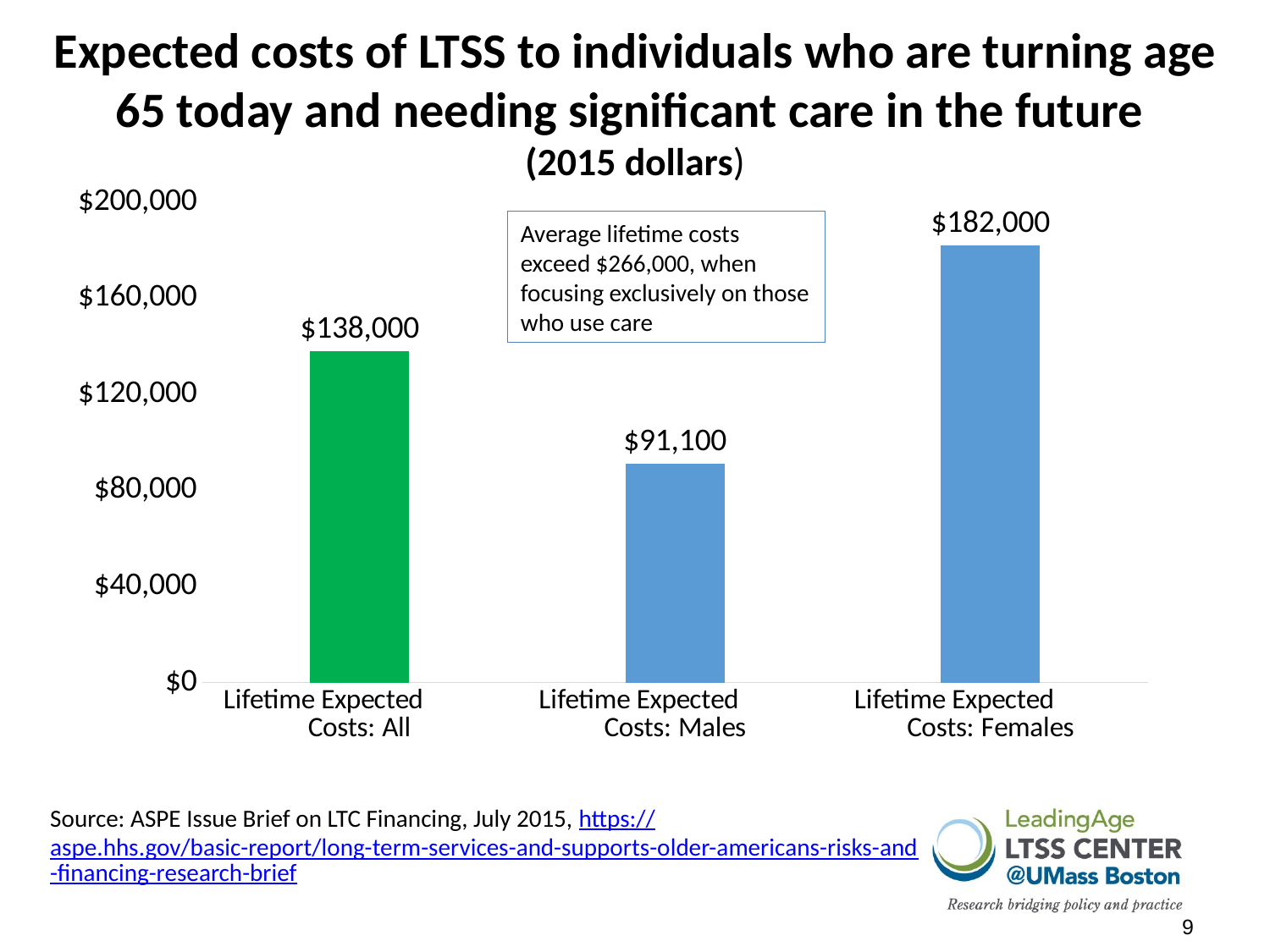
What kind of chart is shown on the slide? bar chart What is the value for Lifetime Expected Costs: All? $138,000 What is the value for Lifetime Expected Costs: Males? $91,100 What colour is the bar for Lifetime Expected Costs: All? green What is the difference between Lifetime Expected Costs: Females and Lifetime Expected Costs: All? $44,000 Which category has the lowest value? Lifetime Expected Costs: Males How many categories are shown in the chart? 3 What is the difference between Lifetime Expected Costs: Females and Lifetime Expected Costs: Males? $90,900 Which is larger, Lifetime Expected Costs: All or Lifetime Expected Costs: Males? Lifetime Expected Costs: All Which category has the highest value? Lifetime Expected Costs: Females What is the value for Lifetime Expected Costs: Females? $182,000 Is the value for Lifetime Expected Costs: Males greater or less than $120,000? less